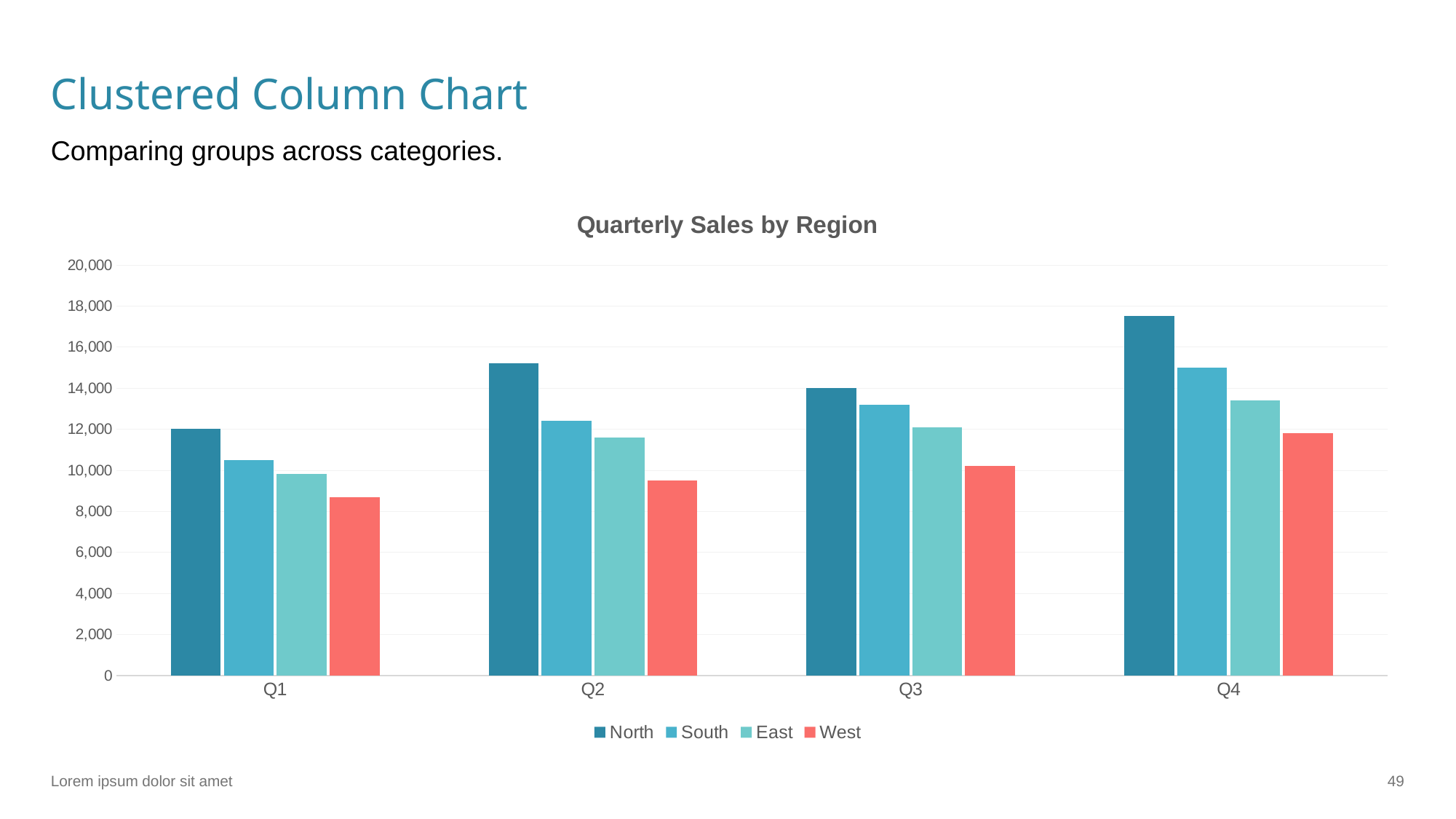
Which is larger, the North value in Q2 or the North value in Q3? Q2 Is the South value for Q4 greater or less than 14,000? greater Do the West values rise or fall from Q1 to Q4? rise How many series does the legend list? 4 In which quarter is the North value highest? Q4 In which quarter is the West value lowest? Q1 What kind of chart is shown on the slide? bar chart How many quarters are shown on the x axis of the chart? 4 Is the West value for Q1 greater or less than 10,000? less Which series is shown in red in the chart? West Is the North value for Q4 greater or less than 16,000? greater What is the title of the chart? Quarterly Sales by Region